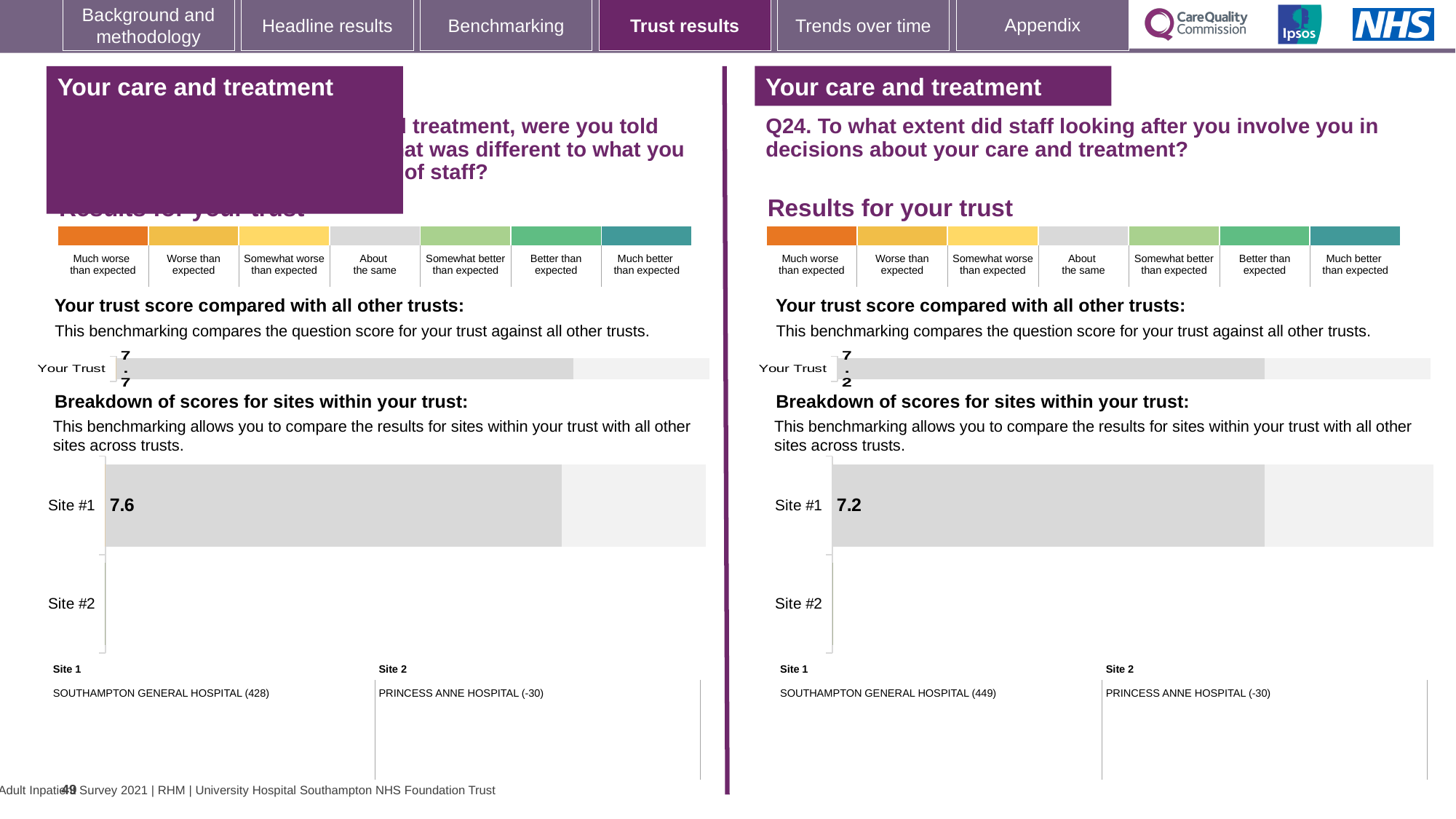
Which is larger: the Site #1 score on the left-hand chart or the Site #1 score on the right-hand chart for Q24? Left-hand chart (7.6) On the right-hand chart for Q24, which hospital is listed as Site 1? Southampton General Hospital On the right-hand breakdown of sites chart for Q24, which site has no bar plotted? Site #2 On the left-hand chart, what is the score shown for Site #1 in the breakdown of sites? 7.6 On the left-hand chart, what is the score shown for Your Trust? 7.7 On the left-hand chart, what is the difference between the Your Trust score and the Site #1 score? 0.1 What kind of chart is used to show the Your Trust score on the right-hand side for Q24? Bar chart On the right-hand chart for Q24, what is the difference between the Your Trust score and the Site #1 score? 0 On the right-hand chart for Q24, what is the score shown for Site #1 in the breakdown of sites? 7.2 On the left-hand breakdown of sites chart, how many sites are listed? 2 On the right-hand chart for Q24, what is the score shown for Your Trust? 7.2